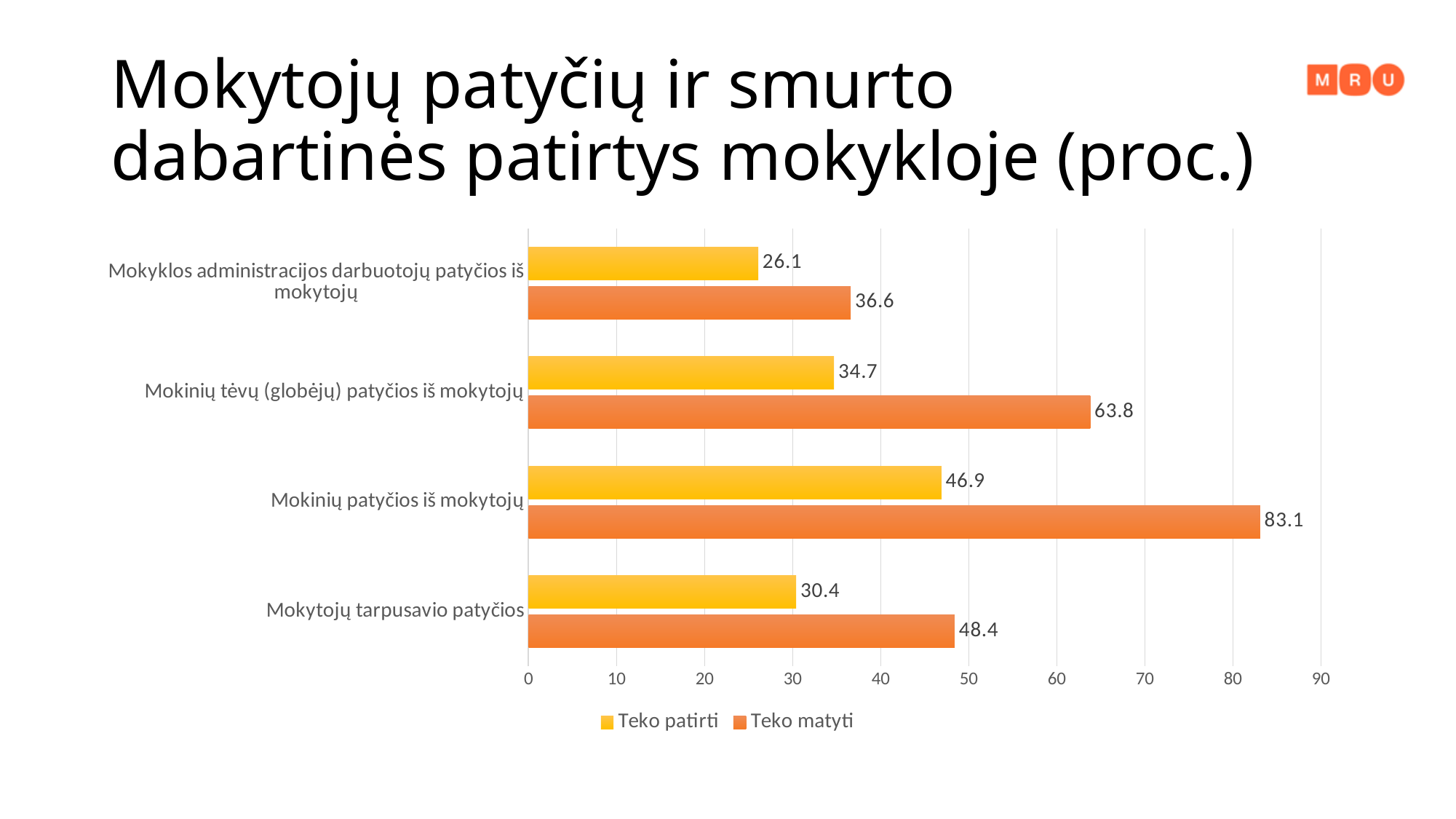
What is the 'Teko patirti' value for 'Mokytojų tarpusavio patyčios'? 30.4 Which is larger: the 'Teko patirti' value for 'Mokinių patyčios iš mokytojų' or the 'Teko matyti' value for 'Mokytojų tarpusavio patyčios'? Teko matyti for Mokytojų tarpusavio patyčios Which category has the highest 'Teko matyti' value? Mokinių patyčios iš mokytojų What is the 'Teko patirti' value for 'Mokyklos administracijos darbuotojų patyčios iš mokytojų'? 26.1 Which series is shown in orange? Teko matyti What kind of chart is shown on the slide? bar chart How many series does the legend list? 2 How many categories are shown on the chart? 4 What is the difference between the 'Teko matyti' and 'Teko patirti' values for 'Mokinių tėvų (globėjų) patyčios iš mokytojų'? 29.1 What is the 'Teko matyti' value for 'Mokinių patyčios iš mokytojų'? 83.1 Which category has the lowest 'Teko patirti' value? Mokyklos administracijos darbuotojų patyčios iš mokytojų Is the 'Teko matyti' value for 'Mokinių tėvų (globėjų) patyčios iš mokytojų' greater or less than 60? greater